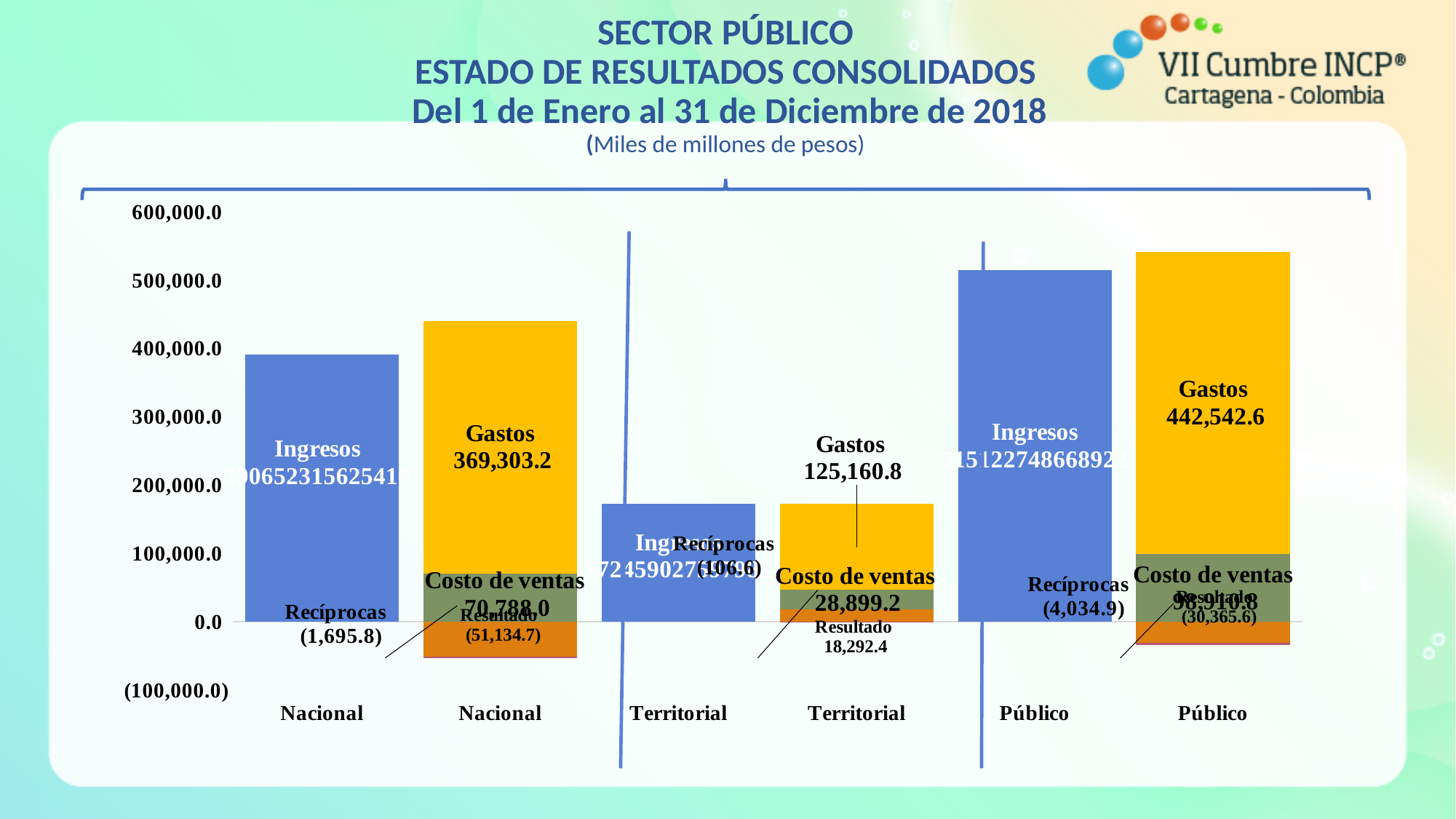
What is the value of Gastos for the Público sector? 442,542.6 What kind of chart is shown on the slide? Bar chart Which is larger, the Costo de ventas for Nacional or for Público? Público What is the difference between Gastos for Público and Gastos for Nacional? 73,239.4 Which sector has the highest Gastos? Público What is the Recíprocas value for the Público sector? (4,034.9) What is the Resultado for the Territorial sector? 18,292.4 Is the Ingresos value for the Territorial sector greater or less than 200,000.0? less What is the value of Gastos for the Nacional sector? 369,303.2 What is the Costo de ventas for the Territorial sector? 28,899.2 Which sector has the lowest Gastos? Territorial What is the Resultado for the Nacional sector? (51,134.7)